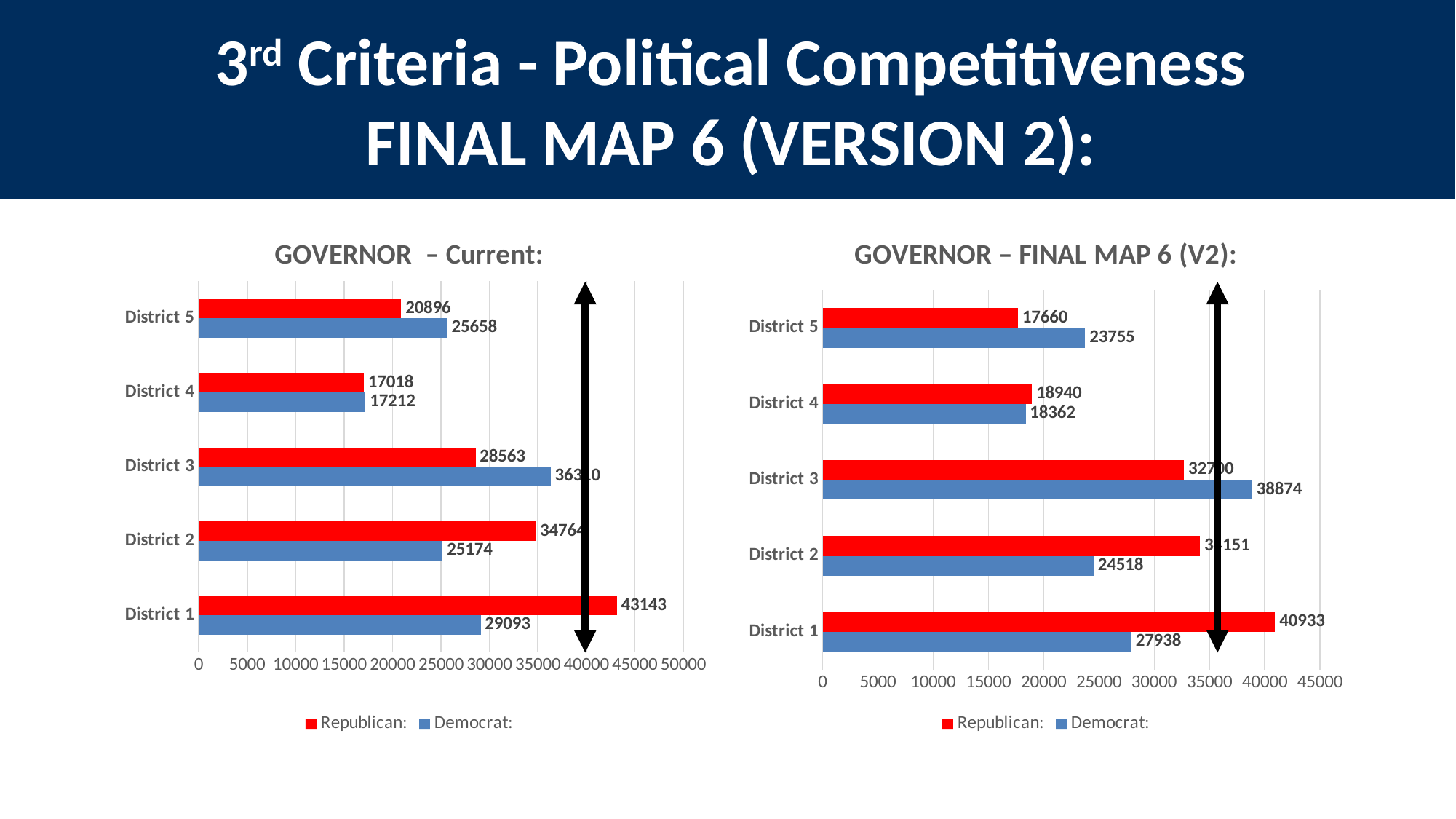
In the GOVERNOR – Current chart, what is the Republican value for District 1? 43143 In the GOVERNOR – Current chart, is the Democrat value for District 3 greater or less than 35000? greater How many districts are shown in the GOVERNOR – Current chart? 5 In the GOVERNOR – FINAL MAP 6 (V2) chart, is the Republican or Democrat value larger for District 4? Republican In the GOVERNOR – Current chart, what is the difference between the Republican and Democrat values for District 1? 14050 In the GOVERNOR – Current chart, which district has the highest Republican value? District 1 In the GOVERNOR – FINAL MAP 6 (V2) chart, what is the difference between the Democrat and Republican values for District 5? 6095 In the GOVERNOR – FINAL MAP 6 (V2) chart, what is the Republican value for District 5? 17660 In the GOVERNOR – FINAL MAP 6 (V2) chart, which district has the lowest Democrat value? District 4 In the GOVERNOR – FINAL MAP 6 (V2) chart, what is the Democrat value for District 3? 38874 In the GOVERNOR – Current chart, what is the Democrat value for District 5? 25658 How many series does the legend of the GOVERNOR – FINAL MAP 6 (V2) chart list? 2